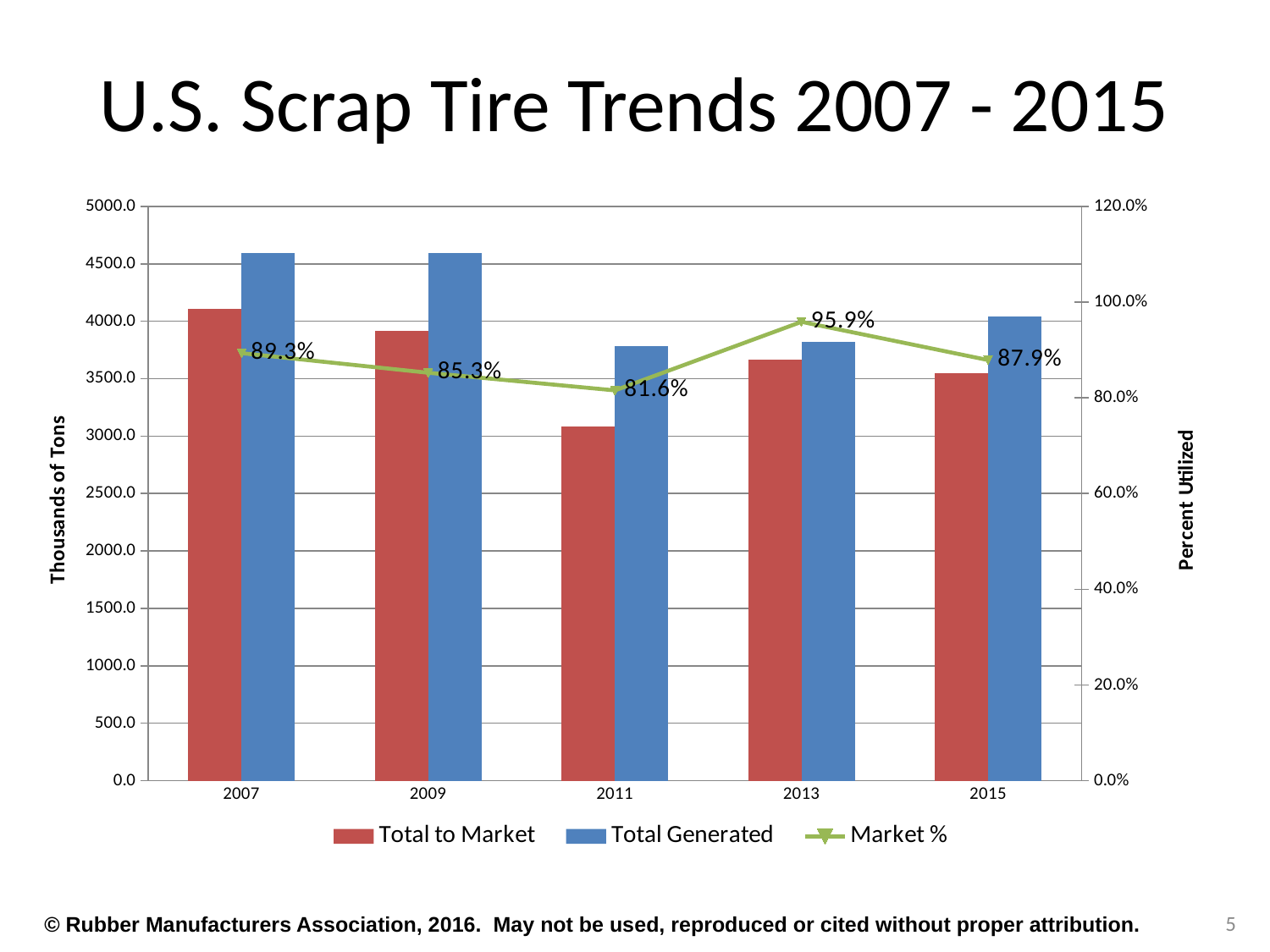
In which year is the Total to Market bar lowest? 2011 Which year has the larger Market %, 2007 or 2015? 2007 What is the Market % value for 2013? 95.9% What is the difference between the Market % in 2013 and in 2011? 14.3% In which year is the Market % highest? 2013 What is the Market % value for 2011? 81.6% Does the Market % rise or fall from 2007 to 2011? fall How many series does the legend list? 3 In which year is the Market % lowest? 2011 Is the Total to Market value for 2011 greater or less than 3500? less Is the Total Generated value for 2007 greater or less than 4500? greater How many years are shown on the x axis? 5